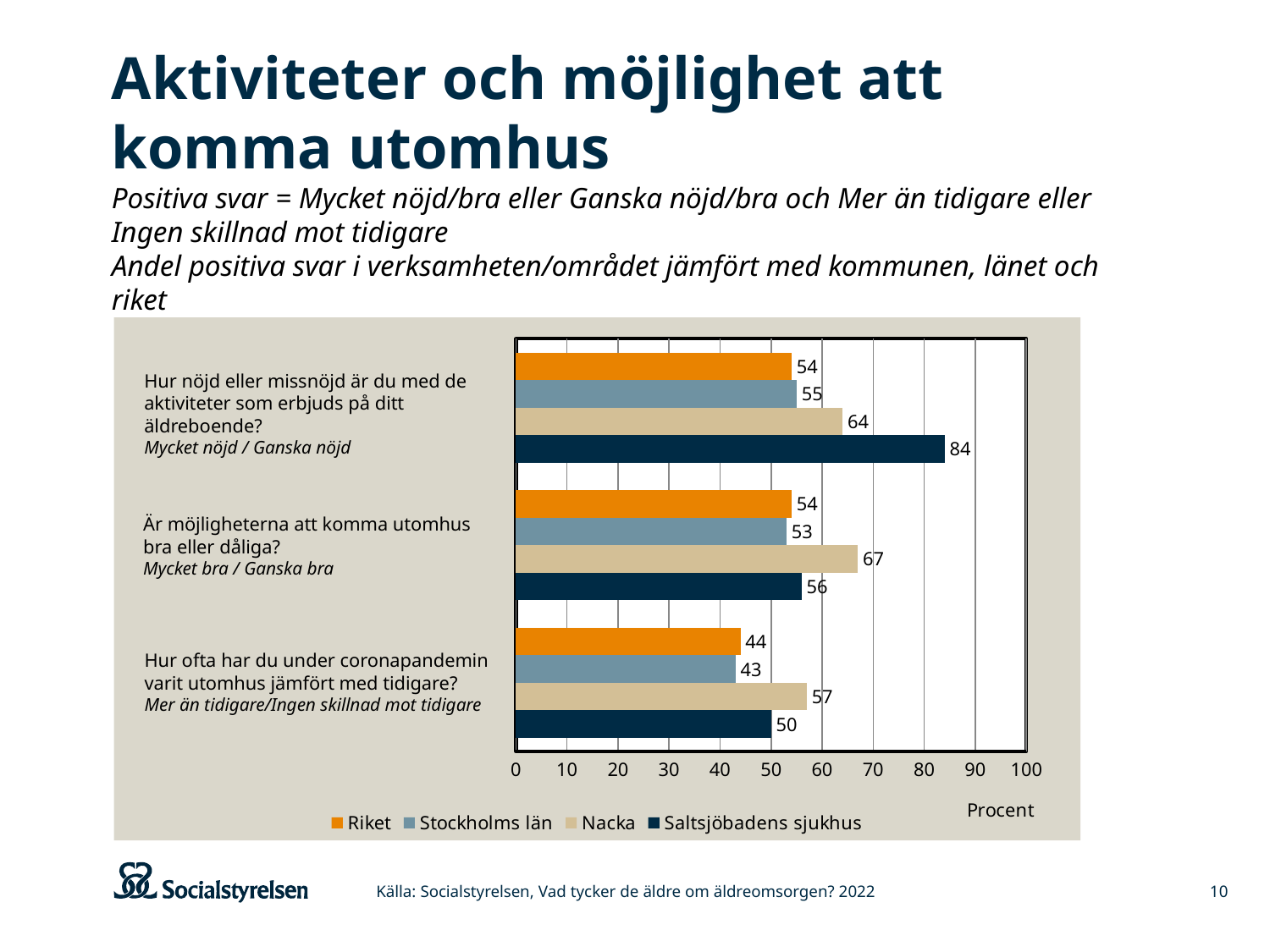
What is the value for Saltsjöbadens sjukhus on the question 'Hur nöjd eller missnöjd är du med de aktiviteter som erbjuds på ditt äldreboende?' 84 What is the label on the horizontal axis of the chart? Procent What kind of chart is shown on the slide? Bar chart Which series has the highest value on the question 'Hur nöjd eller missnöjd är du med de aktiviteter som erbjuds på ditt äldreboende?' Saltsjöbadens sjukhus Which is larger on the question 'Hur ofta har du under coronapandemin varit utomhus jämfört med tidigare?': Nacka or Saltsjöbadens sjukhus? Nacka What is the value for Stockholms län on the question 'Hur ofta har du under coronapandemin varit utomhus jämfört med tidigare?' 43 What is the difference between Saltsjöbadens sjukhus and Riket on the question 'Hur nöjd eller missnöjd är du med de aktiviteter som erbjuds på ditt äldreboende?' 30 What is the value for Nacka on the question 'Är möjligheterna att komma utomhus bra eller dåliga?' 67 What is the difference between Nacka and Saltsjöbadens sjukhus on the question 'Är möjligheterna att komma utomhus bra eller dåliga?' 11 How many series does the legend list? 4 Which series has the lowest value on the question 'Hur ofta har du under coronapandemin varit utomhus jämfört med tidigare?' Stockholms län How many questions (categories) are shown on the chart? 3